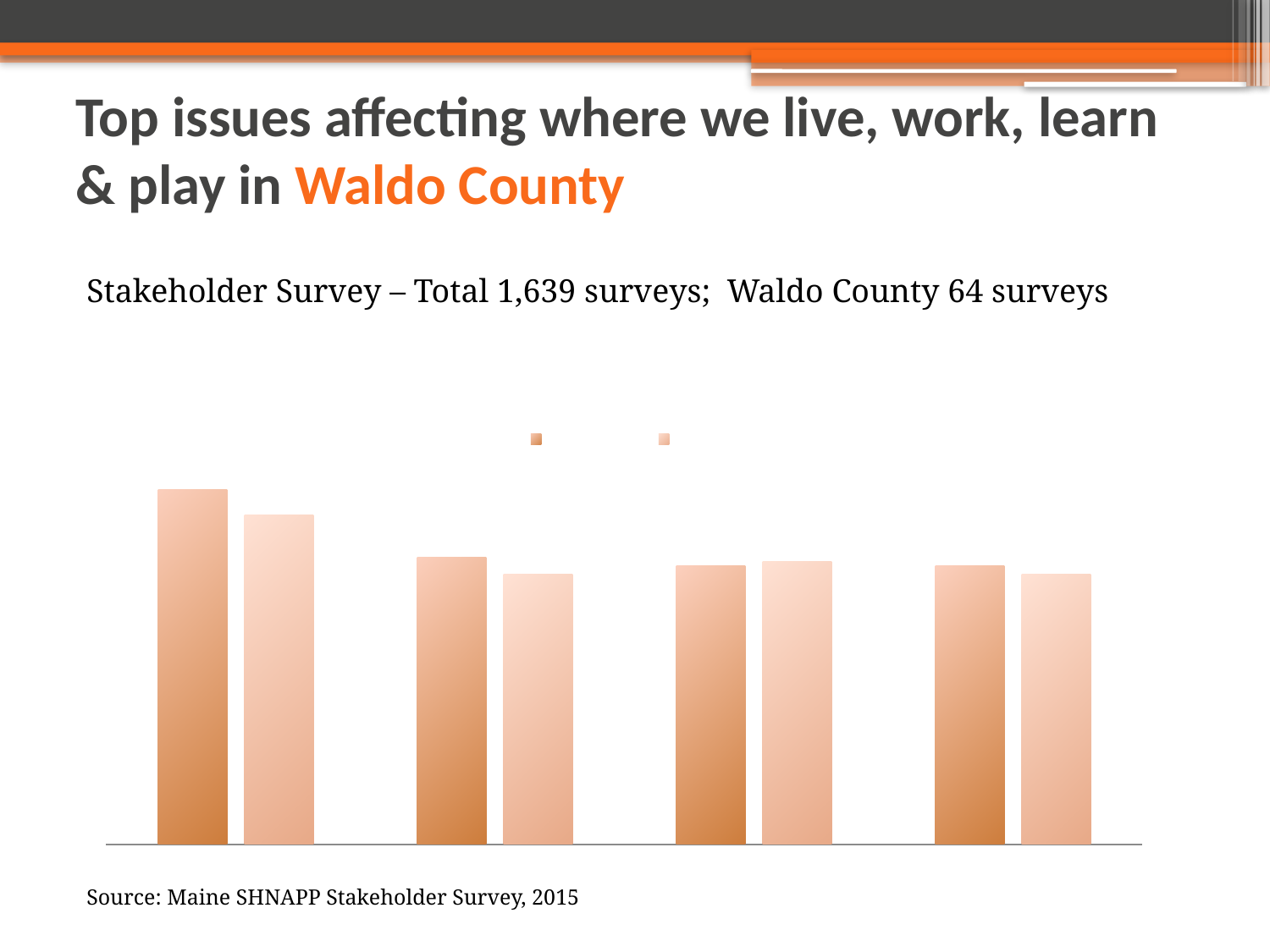
Which group of bars, counting from the left, contains the tallest bar in the chart? the first group What kind of chart is shown on the slide? bar chart How many series does the chart's legend show? 2 How many bars are plotted in total in the chart? 8 In the leftmost group of bars, is the darker orange bar or the lighter orange bar taller? the darker orange bar Does the chart display any numeric axis labels or data labels? No How many groups of bars are plotted in the chart? 4